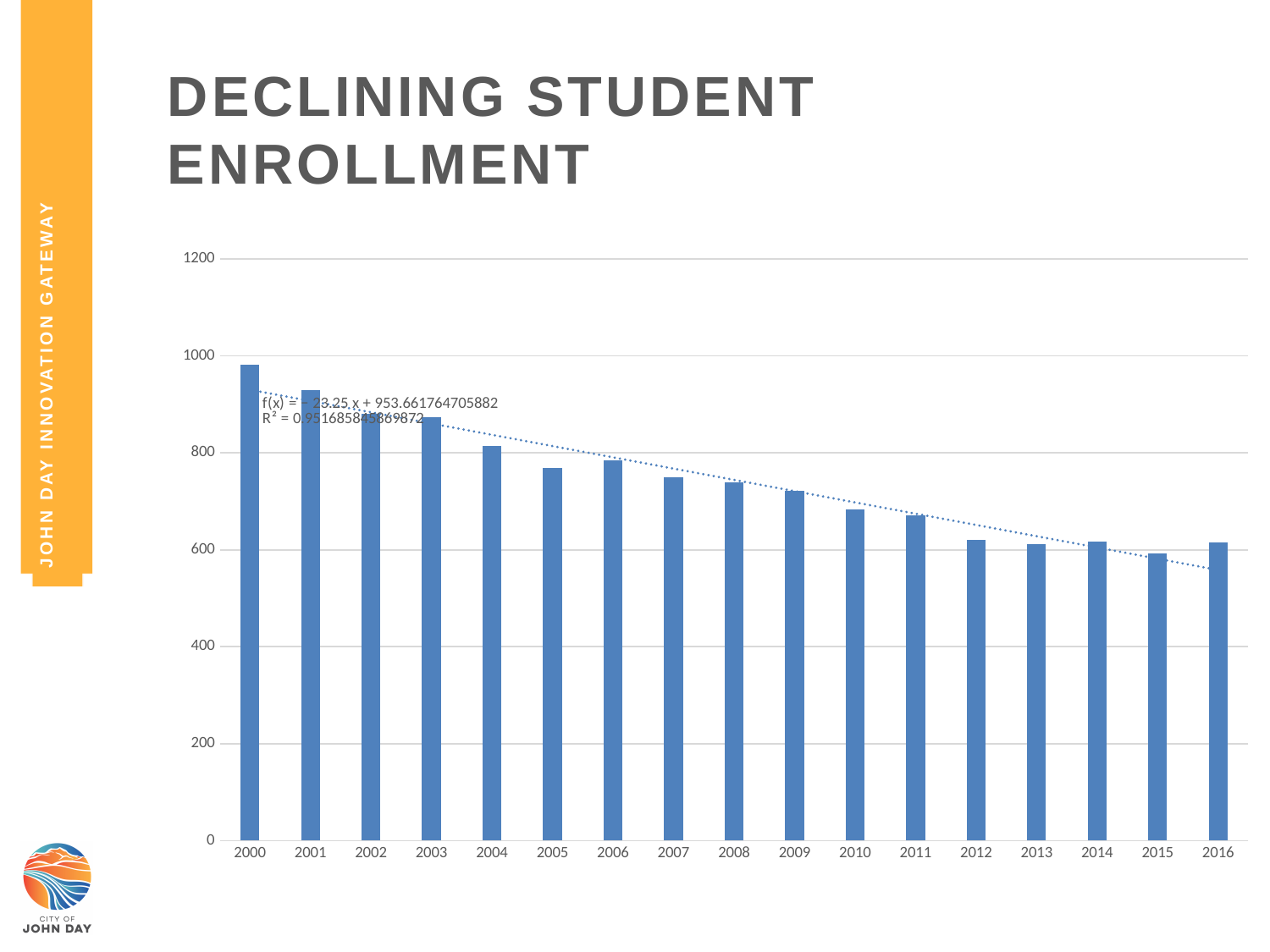
What is the R² value shown for the trendline on the chart? 0.951685845869872 Is the value for 2005 greater or less than 800? less Is the value for 2000 greater or less than 800? greater Which year has the larger enrollment, 2002 or 2010? 2002 What kind of chart is shown on the slide? bar chart Which year has the highest student enrollment in the chart? 2000 What is the title of the slide containing the chart? Declining Student Enrollment Is the value for 2010 greater or less than 800? less How many years are plotted on the x axis of the chart? 17 Do the enrollment values generally rise or fall from 2000 to 2016? fall Which year has the lowest student enrollment in the chart? 2015